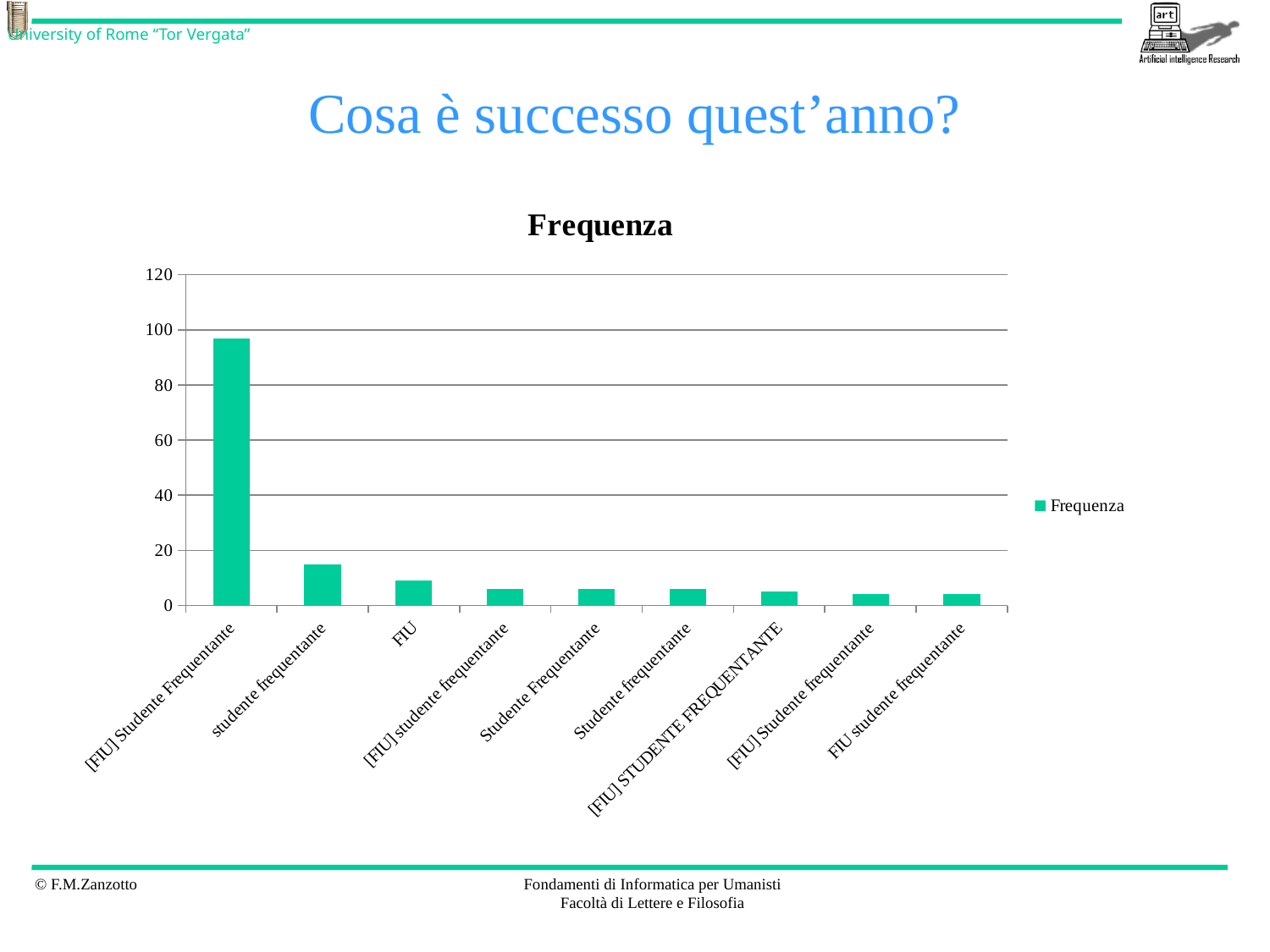
Which is larger, the value for "[FIU] Studente Frequentante" or the value for "studente frequentante"? [FIU] Studente Frequentante What is the name of the series shown in the legend? Frequenza Which category has the highest value in the chart? [FIU] Studente Frequentante Is the value for "studente frequentante" greater or less than 20? less What is the title of the chart? Frequenza How many series does the legend list? 1 What kind of chart is shown on the slide? bar chart Is the value for "FIU" greater or less than 20? less Is the value for "[FIU] Studente Frequentante" greater or less than 80? greater How many categories are plotted on the x axis of the chart? 9 Do the values generally rise or fall moving from left to right along the x axis? fall